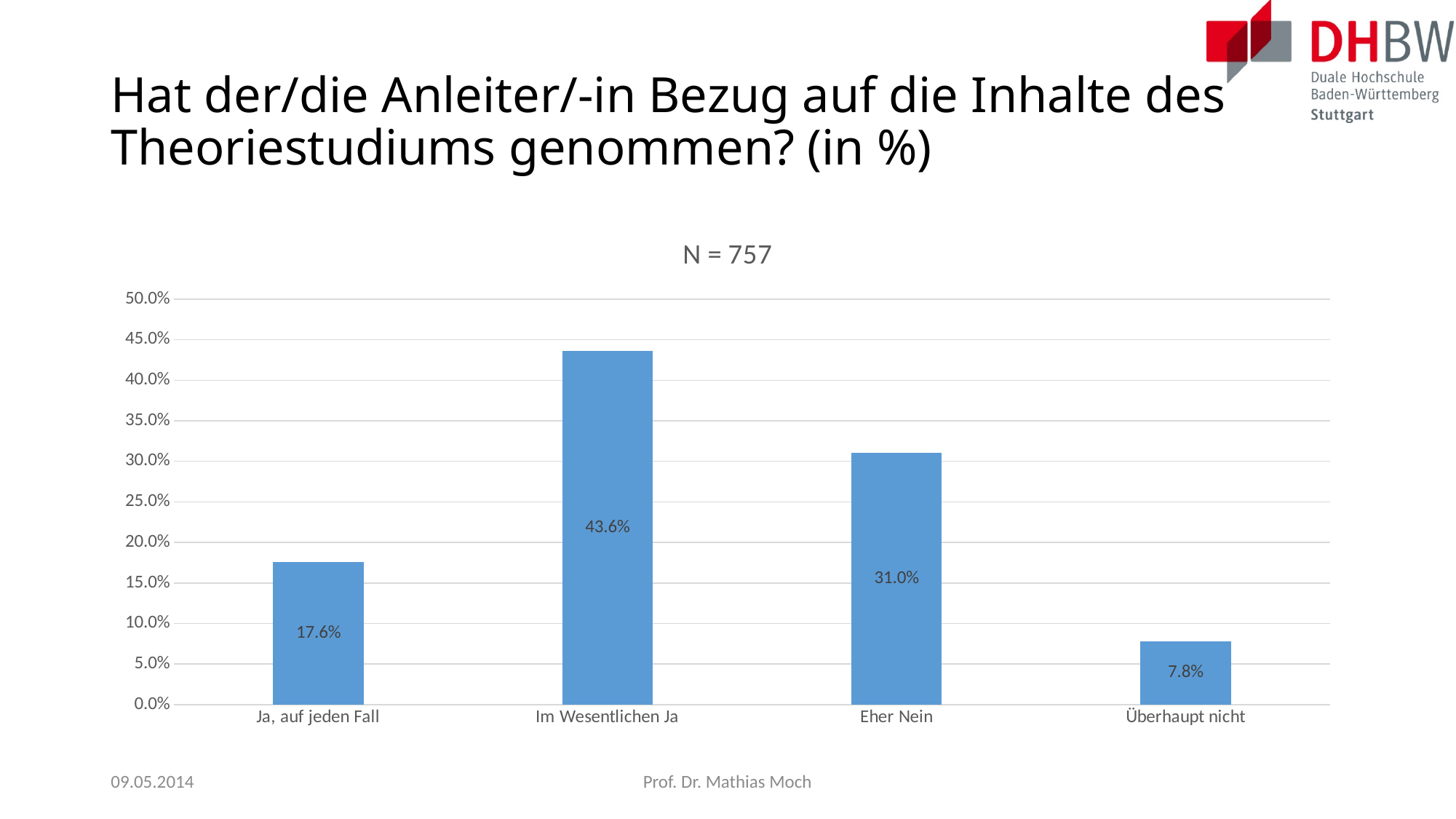
What kind of chart is shown on the slide? bar chart What is the difference between the values for "Im Wesentlichen Ja" and "Eher Nein"? 12.6% Which category has the lowest value? Überhaupt nicht How many categories are shown on the x axis? 4 Which is larger, the value for "Ja, auf jeden Fall" or the value for "Eher Nein"? Eher Nein What is the value for "Im Wesentlichen Ja"? 43.6% What is the value for "Eher Nein"? 31.0% Is the value for "Eher Nein" greater or less than 25.0%? greater What is the chart's title? N = 757 What is the value for "Ja, auf jeden Fall"? 17.6% What is the value for "Überhaupt nicht"? 7.8% Which category has the highest value? Im Wesentlichen Ja